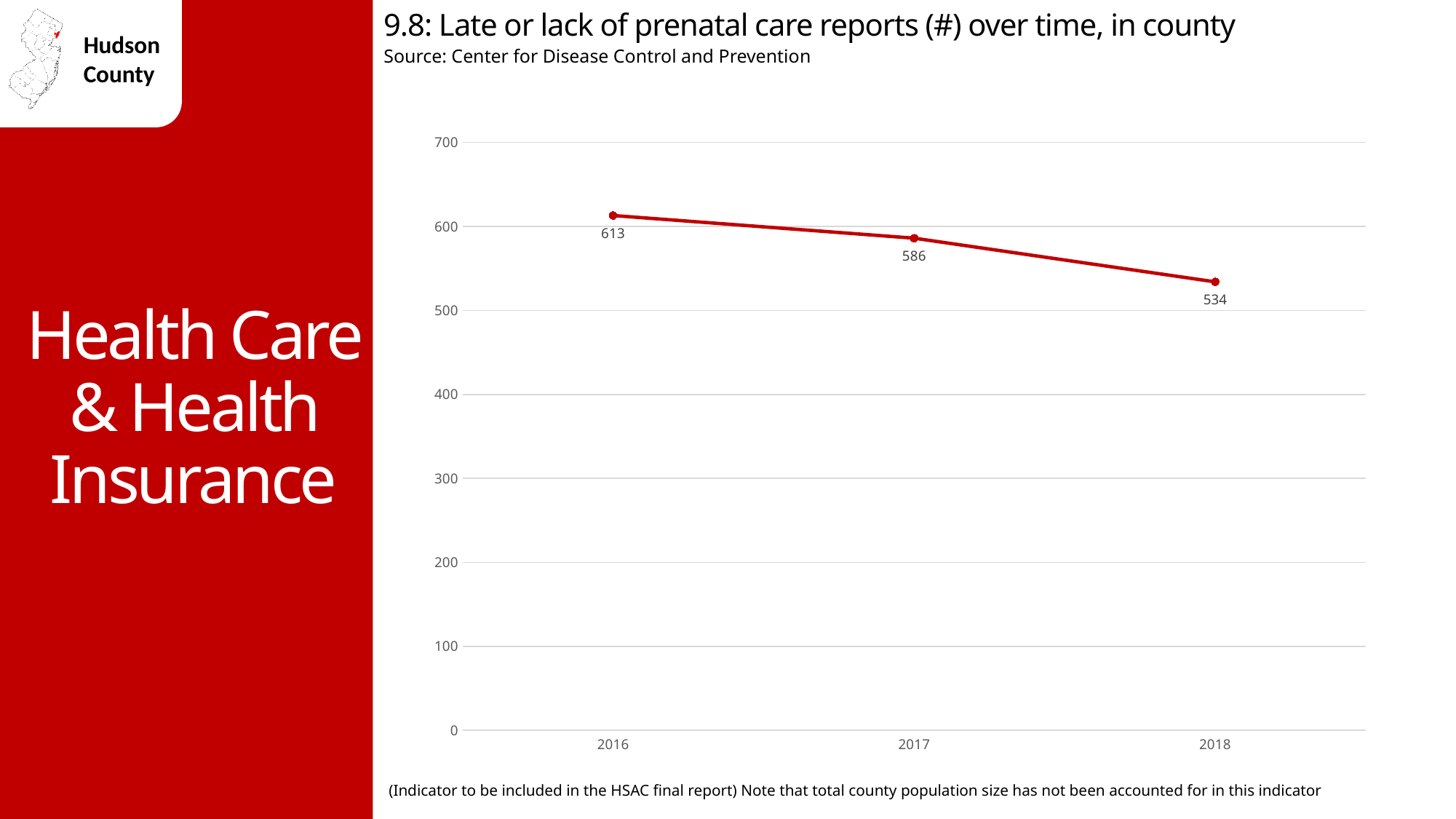
Which year has more late or lack of prenatal care reports, 2017 or 2018? 2017 What is the difference between the number of reports in 2016 and 2018? 79 Which year has the highest number of late or lack of prenatal care reports? 2016 What is the difference between the number of reports in 2017 and 2018? 52 What is the number of late or lack of prenatal care reports in 2016? 613 What is the number of late or lack of prenatal care reports in 2017? 586 What kind of chart is shown on the slide? Line chart How many years are plotted on the chart? 3 Is the value for 2016 greater or less than 600? greater What is the number of late or lack of prenatal care reports in 2018? 534 Do the values rise or fall from 2016 to 2018? Fall Which year has the lowest number of late or lack of prenatal care reports? 2018